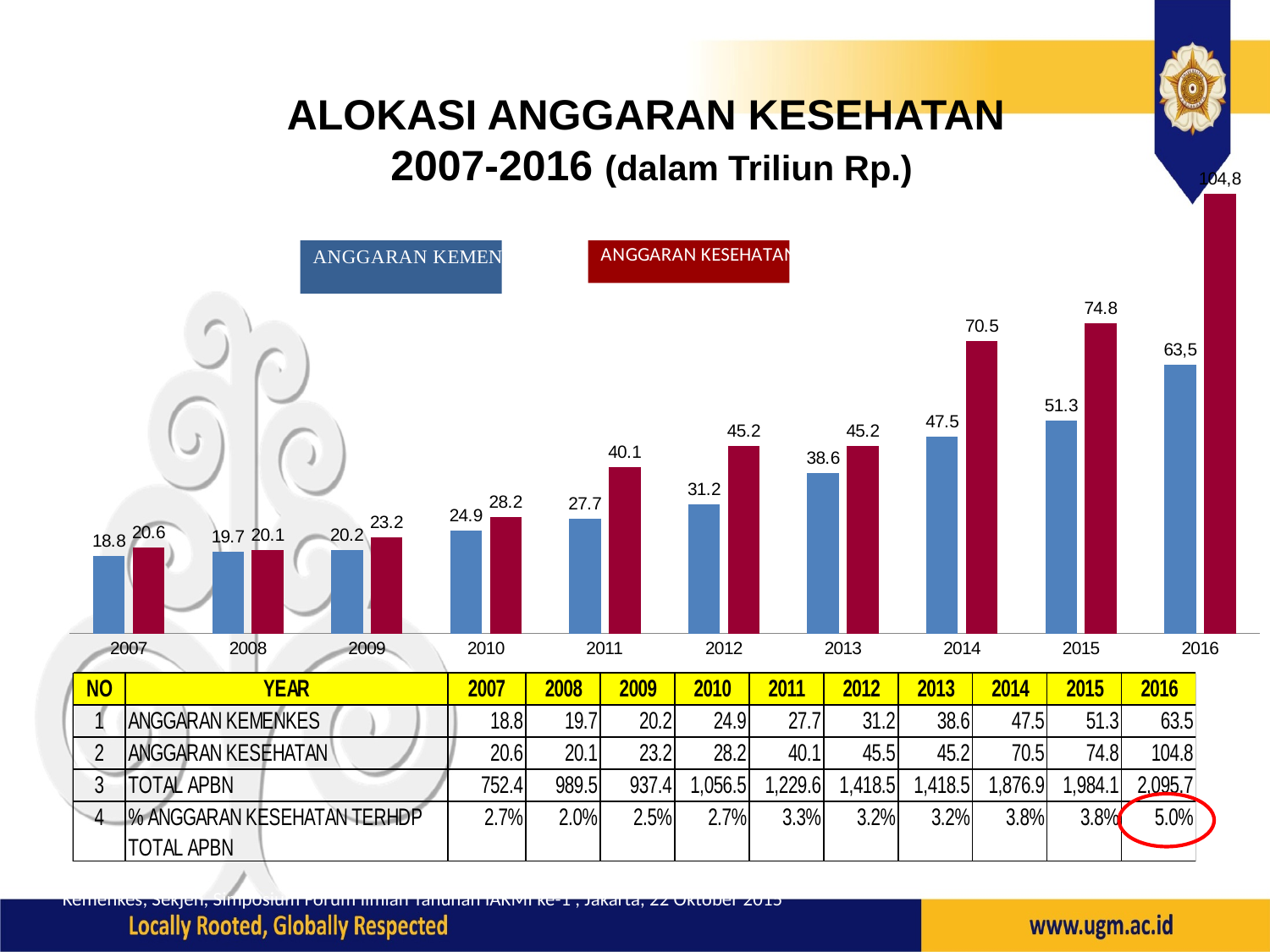
In 2013, which is larger: ANGGARAN KEMENKES or ANGGARAN KESEHATAN? ANGGARAN KESEHATAN Does the ANGGARAN KEMENKES (blue bar) rise or fall from 2007 to 2016? rises What is the value of ANGGARAN KEMENKES (blue bar) for 2014? 47.5 In which year is the ANGGARAN KEMENKES (blue bar) lowest? 2007 How many years are shown on the x axis of the chart? 10 What is the value of ANGGARAN KESEHATAN (red bar) for 2011? 40.1 What is the difference between ANGGARAN KESEHATAN and ANGGARAN KEMENKES in 2015? 23.5 In which year is the ANGGARAN KESEHATAN (red bar) highest? 2016 What kind of chart is shown on the slide? bar chart How many series does the chart legend list? 2 What is the value of ANGGARAN KESEHATAN (red bar) for 2016? 104,8 By how much did ANGGARAN KESEHATAN (red bar) increase from 2013 to 2014? 25.3